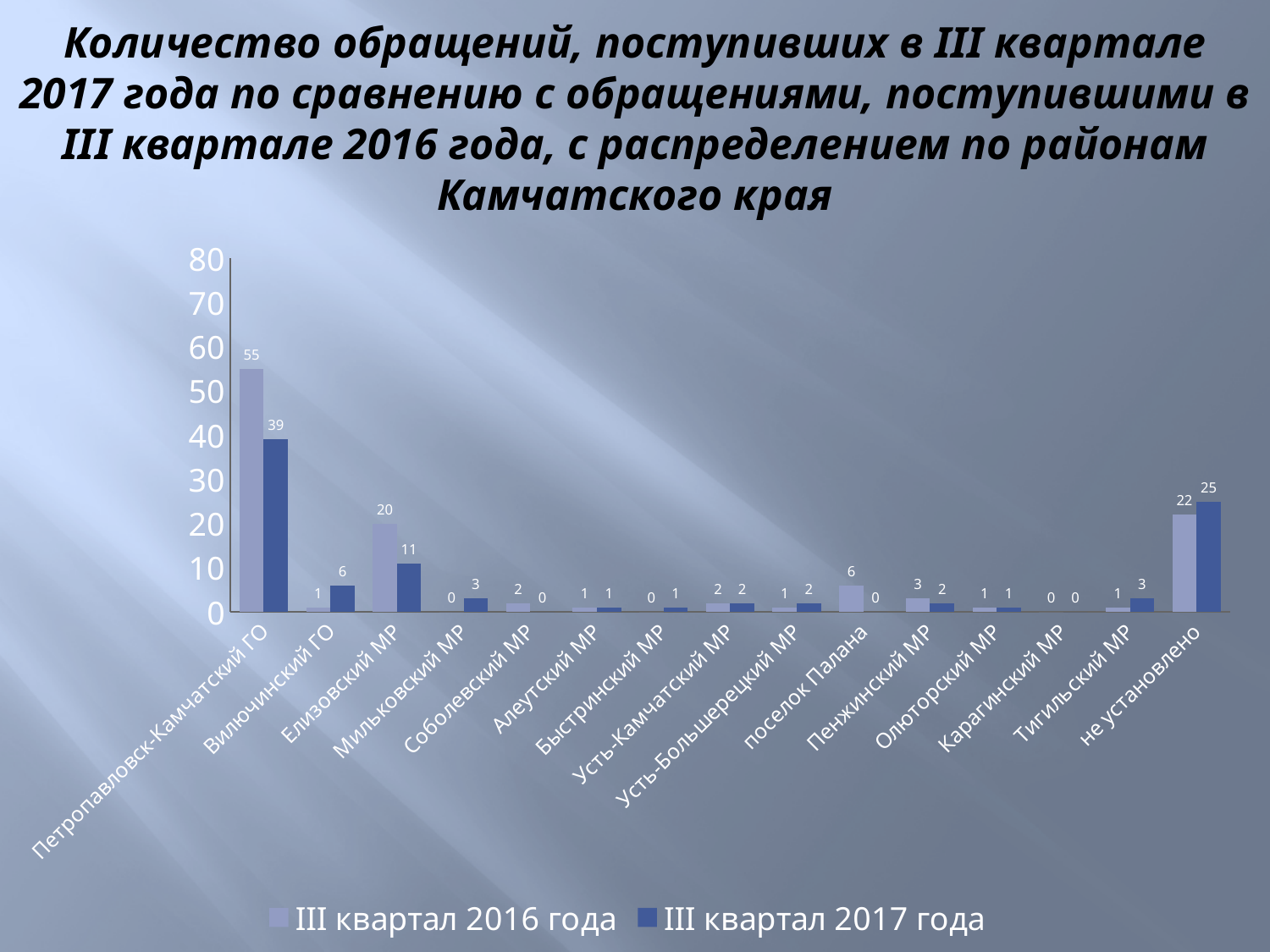
What is the value for Петропавловск-Камчатский ГО in III квартал 2016 года? 55 What is the value for Елизовский МР in III квартал 2017 года? 11 Which is larger for Вилючинский ГО: the III квартал 2016 года value or the III квартал 2017 года value? III квартал 2017 года What is the value for не установлено in III квартал 2016 года? 22 How many series does the legend list? 2 How many districts (categories) are shown on the x axis? 15 What is the value for Петропавловск-Камчатский ГО in III квартал 2017 года? 39 Which category has the highest value in III квартал 2017 года? Петропавловск-Камчатский ГО What is the difference between the III квартал 2016 года and III квартал 2017 года values for Петропавловск-Камчатский ГО? 16 What type of chart is shown on the slide? bar chart What is the difference between the III квартал 2016 года and III квартал 2017 года values for Елизовский МР? 9 Is the value for Петропавловск-Камчатский ГО in III квартал 2016 года greater or less than 50? greater